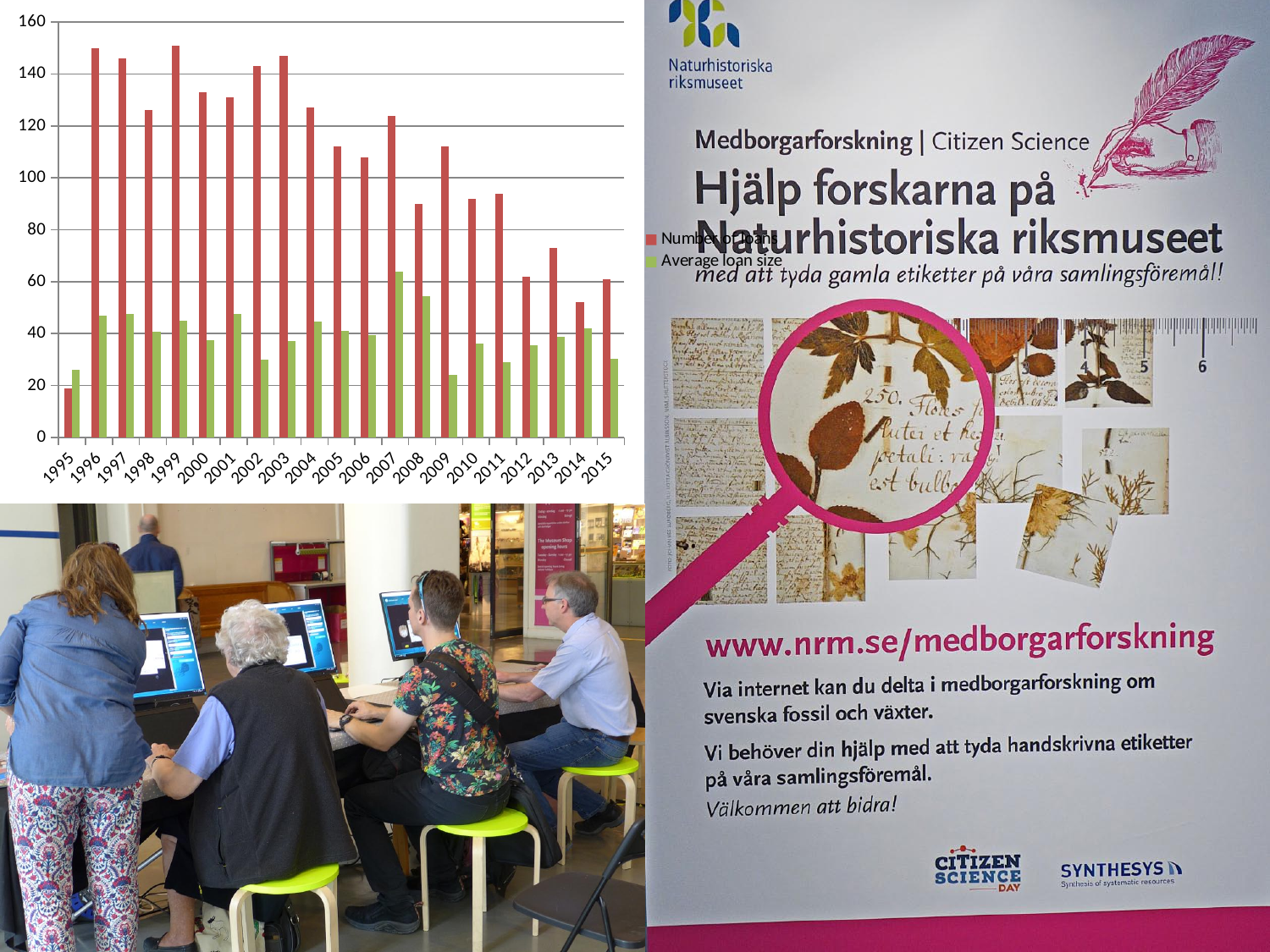
What kind of chart is shown on the slide? bar chart Which year has the larger Number of loans, 2013 or 2014? 2013 Is the Average loan size for 2007 greater or less than 60? greater Is the Number of loans for 2013 greater or less than 60? greater Does the Number of loans rise or fall from 2003 to 2006? fall What colour are the bars for the Number of loans series? red Is the Number of loans for 1996 greater or less than 140? greater Which year has the highest value for Average loan size? 2007 How many years are shown along the x axis of the chart? 21 Which year has the lowest value for Number of loans? 1995 How many series does the chart's legend list? 2